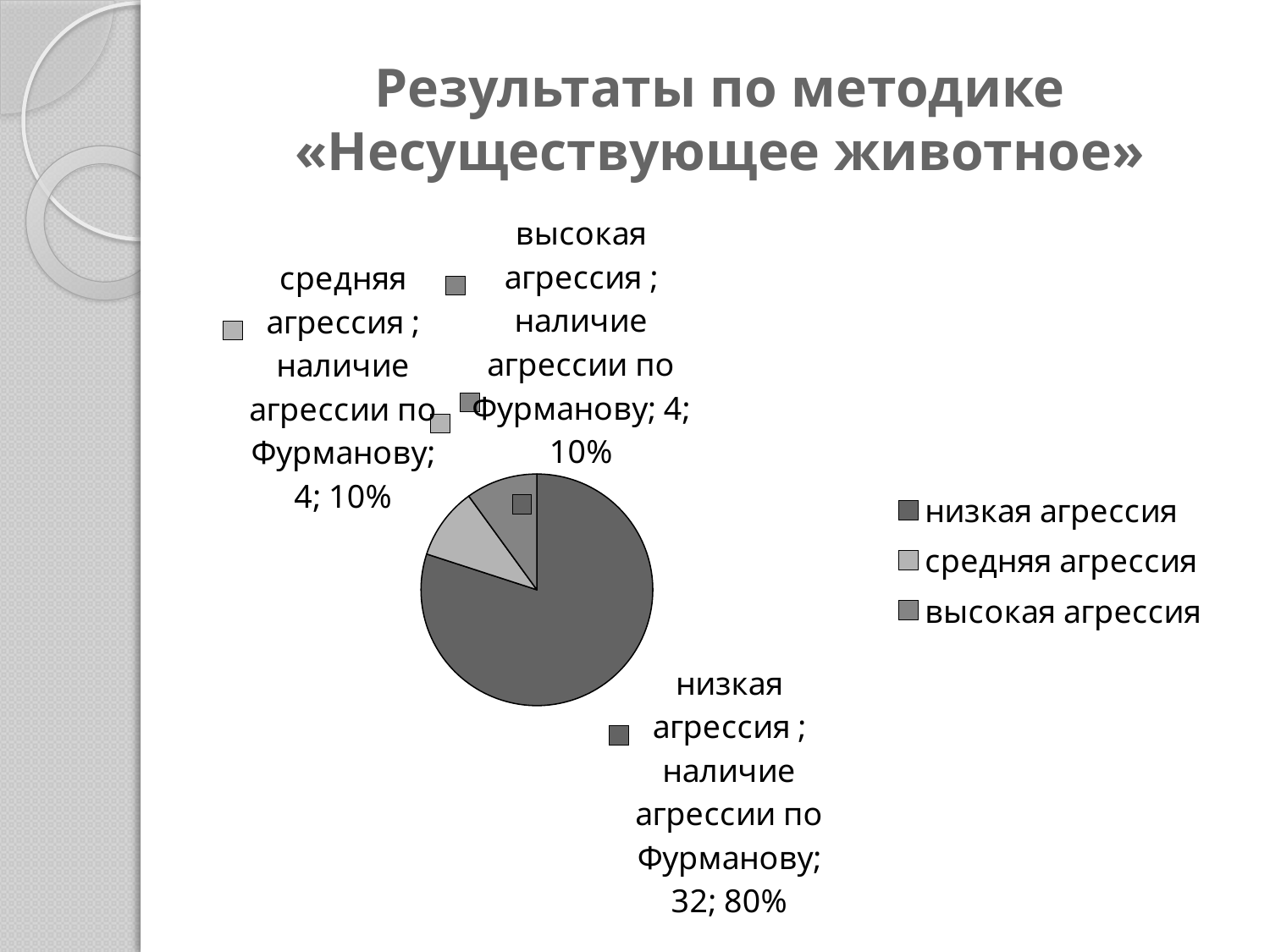
How many entries does the legend of the pie chart list? 3 What is the difference between the value for низкая агрессия and the value for высокая агрессия? 28 What kind of chart is shown on the slide? pie chart How many slices does the pie chart have? 3 Which category has the largest slice in the pie chart? низкая агрессия What is the value for низкая агрессия in the pie chart? 32 What share of the pie does высокая агрессия take? 10% What is the value for высокая агрессия in the pie chart? 4 What is the title of the slide containing the pie chart? Результаты по методике «Несуществующее животное» What share of the pie does низкая агрессия take? 80% Which is larger, the value for низкая агрессия or the value for средняя агрессия? низкая агрессия What is the value for средняя агрессия in the pie chart? 4